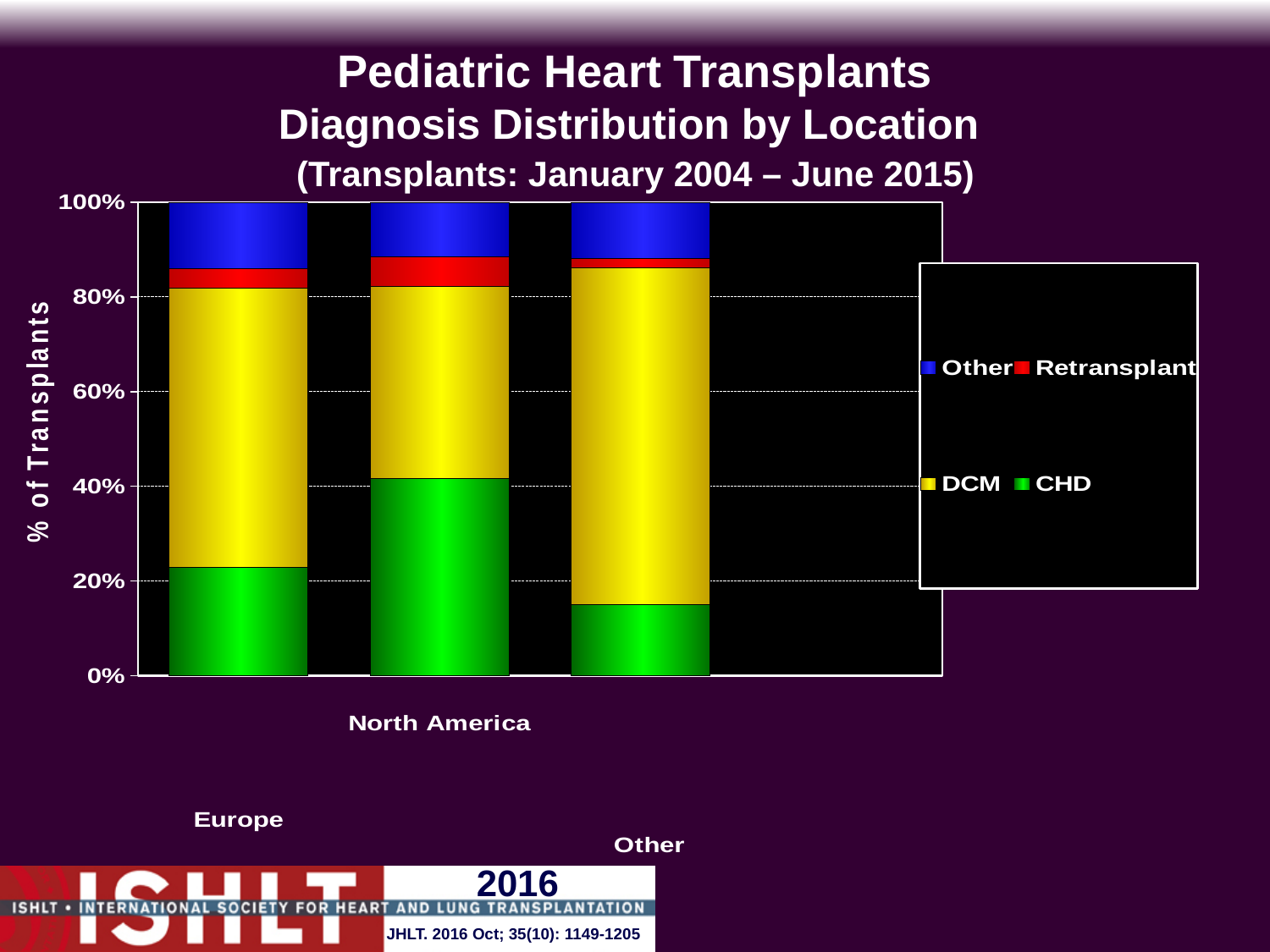
What is the label of the y axis? % of Transplants Is the CHD share for Europe greater or less than 40%? less Which location has the largest DCM share of transplants? Other How many location categories are plotted on the x axis? 3 Is the CHD share for the Other location greater or less than 20%? less Which location has the largest CHD share of transplants? North America Which colour represents DCM in the legend? Yellow How many series does the legend list? 4 What kind of chart is shown on the slide? Stacked bar chart Is the CHD share for North America greater or less than 40%? greater Which location has the smallest CHD share of transplants? Other Which is larger, the CHD share for Europe or the CHD share for the Other location? Europe